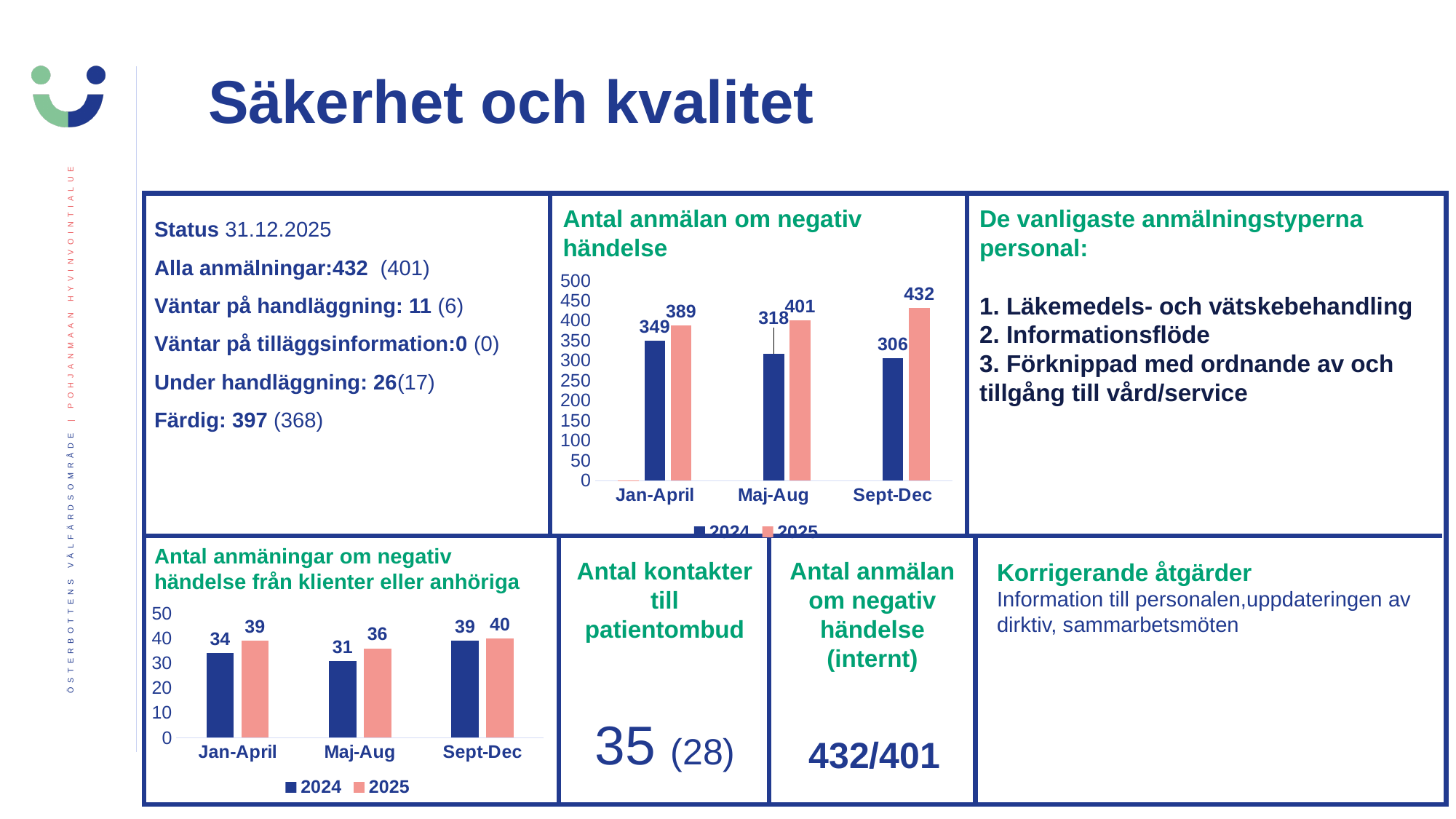
In the chart 'Antal anmälan om negativ händelse', what is the difference between the 2025 and 2024 values for Sept-Dec? 126 In the chart 'Antal anmälan om negativ händelse', how many series does the legend list? 2 In the chart 'Antal anmäningar om negativ händelse från klienter eller anhöriga', how many periods are shown on the x axis? 3 In the chart 'Antal anmäningar om negativ händelse från klienter eller anhöriga', what is the value for 2025 in Jan-April? 39 In the chart 'Antal anmäningar om negativ händelse från klienter eller anhöriga', what is the value for 2024 in Maj-Aug? 31 In the chart 'Antal anmälan om negativ händelse', which period has the lowest 2024 value? Sept-Dec In the chart 'Antal anmäningar om negativ händelse från klienter eller anhöriga', which is larger in Jan-April: 2024 or 2025? 2025 In the chart 'Antal anmälan om negativ händelse', which period has the highest 2025 value? Sept-Dec In the chart 'Antal anmälan om negativ händelse', what is the value for 2024 in Maj-Aug? 318 In the chart 'Antal anmälan om negativ händelse', do the 2025 values rise or fall from Jan-April to Sept-Dec? rise In the chart 'Antal anmälan om negativ händelse', what is the value for 2025 in Sept-Dec? 432 What type of chart is 'Antal anmäningar om negativ händelse från klienter eller anhöriga'? bar chart